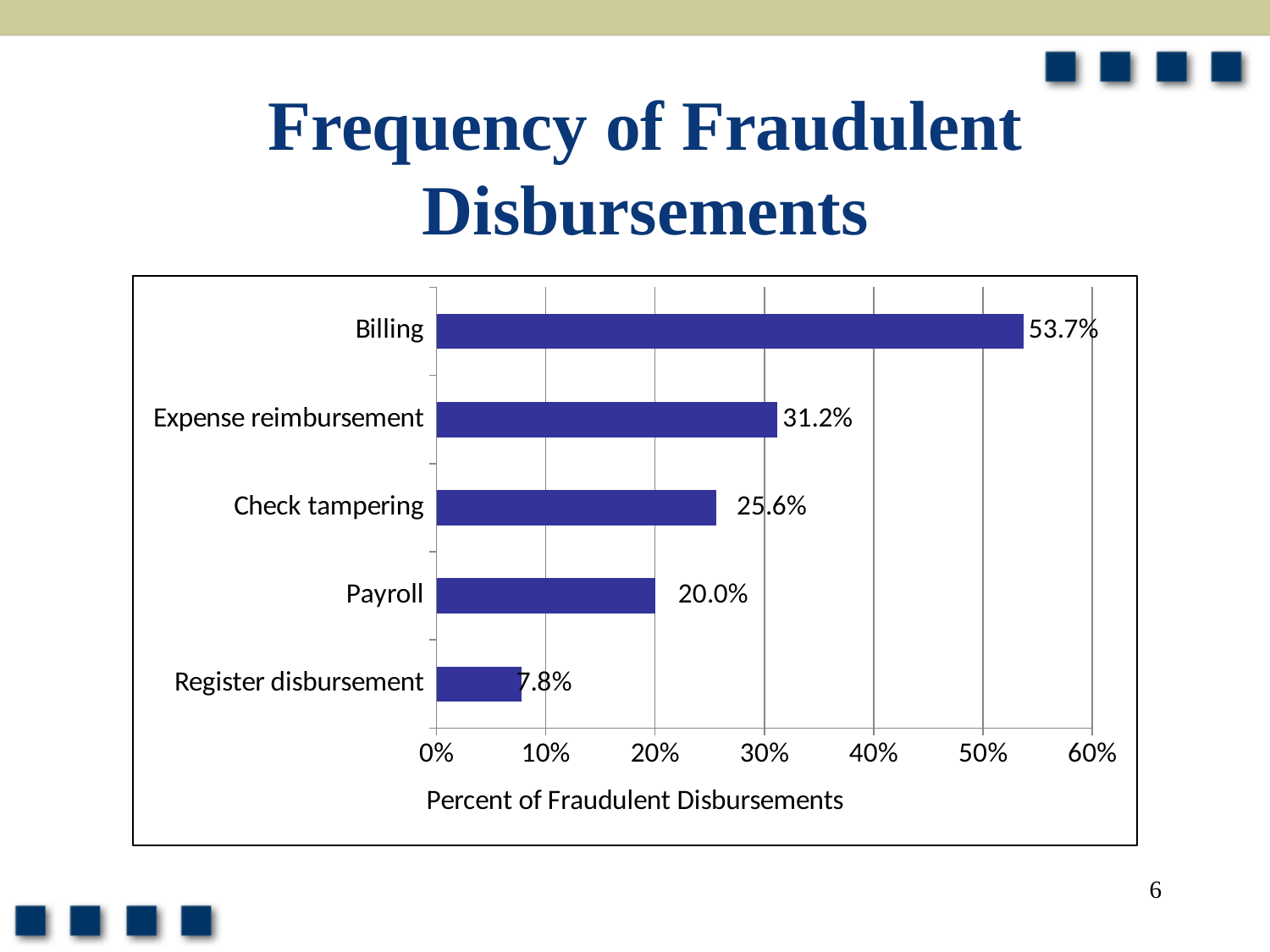
What is the value for Billing? 53.7% What is the difference between the values for Billing and Expense reimbursement? 22.5% Which category has the lowest value? Register disbursement What is the value for Register disbursement? 7.8% Which category has the highest value? Billing What is the value for Check tampering? 25.6% What is the value for Expense reimbursement? 31.2% What kind of chart is shown on the slide? Bar chart What is the value for Payroll? 20.0% What is the label of the horizontal axis? Percent of Fraudulent Disbursements Which is larger, the value for Check tampering or the value for Payroll? Check tampering How many categories are shown in the chart? 5